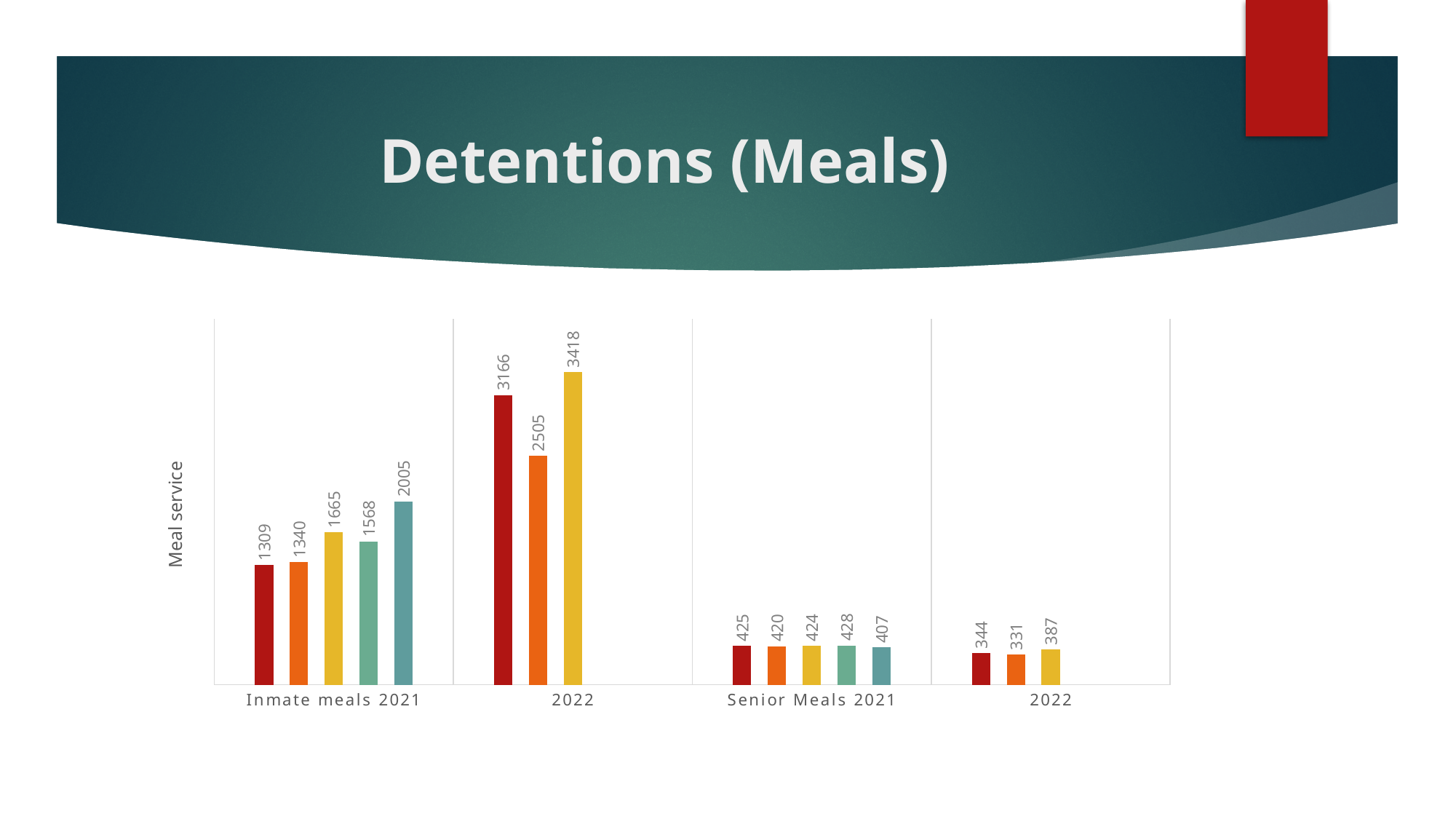
What kind of chart is shown on the slide? Bar chart What is the value of the tallest bar in the 2022 group for inmate meals? 3418 What is the value of the first (dark red) bar in the Inmate meals 2021 group? 1309 What is the value of the yellow bar in the senior meals 2022 group? 387 What is the difference between the yellow bar (3418) and the orange bar (2505) in the inmate meals 2022 group? 913 How many bars are in the senior meals 2022 group? 3 How many bars are in the Inmate meals 2021 group? 5 What is the value of the last (teal) bar in the Inmate meals 2021 group? 2005 What is the lowest value shown in the Senior Meals 2021 group? 407 What is the label on the vertical axis of the chart? Meal service Which is larger: the dark red bar in the inmate meals 2022 group or the dark red bar in the Inmate meals 2021 group? The 2022 bar (3166) What is the difference between the first bar in Senior Meals 2021 (425) and the first bar in senior meals 2022 (344)? 81